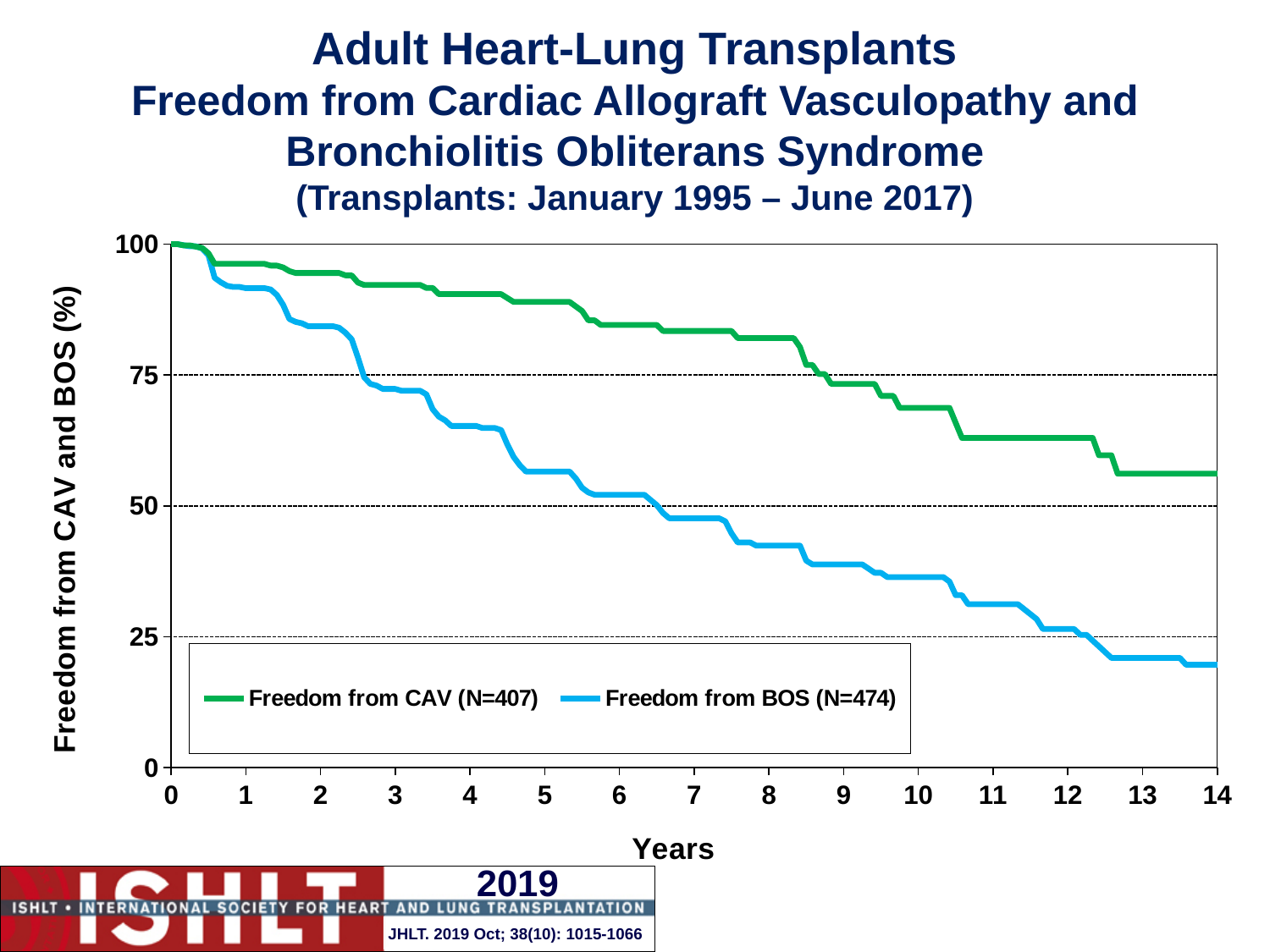
What kind of chart is shown on the slide? line chart What is the label of the x axis? Years Is the value for Freedom from BOS at 4 years greater or less than 75? less Is the value for Freedom from BOS at 5 years greater or less than 50? greater What is the value for Freedom from CAV at year 0? 100 What is the N value shown in the legend for Freedom from BOS? N=474 Is the value for Freedom from BOS at 14 years greater or less than 25? less How many series does the legend list? 2 Do the values for Freedom from CAV rise or fall as the years increase? fall At 10 years, which series has the higher value, Freedom from CAV or Freedom from BOS? Freedom from CAV